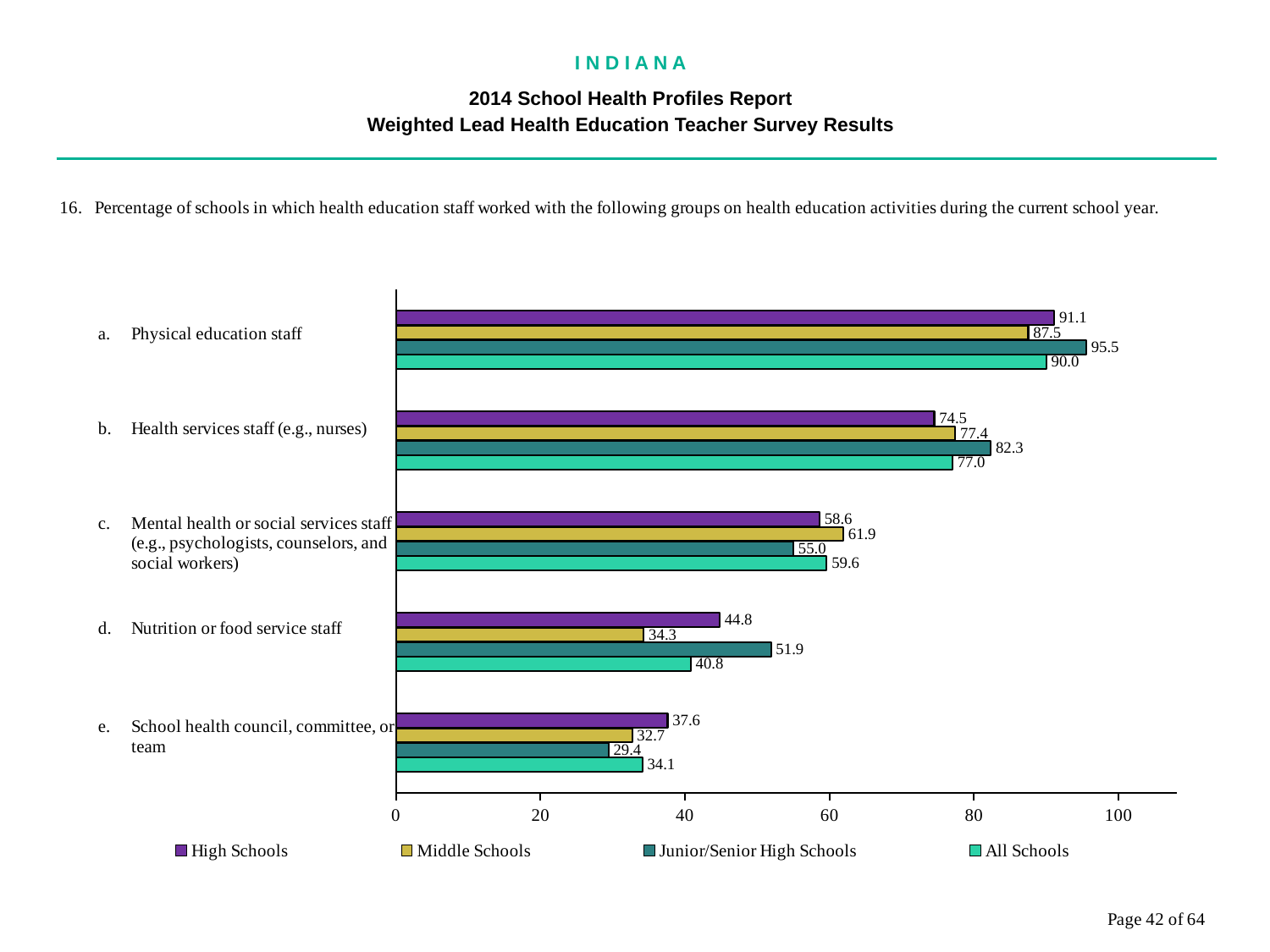
For Mental health or social services staff, which is larger: the Middle Schools value or the High Schools value? Middle Schools Which category has the highest All Schools value? Physical education staff What is the All Schools value for Nutrition or food service staff? 40.8 Is the High Schools value for Health services staff (e.g., nurses) greater or less than 80? less Which legend entry is shown in purple? High Schools Which category has the lowest High Schools value? School health council, committee, or team What is the value for Physical education staff in the Junior/Senior High Schools series? 95.5 What kind of chart is shown on the slide? bar chart What is the difference between the Junior/Senior High Schools and Middle Schools values for Nutrition or food service staff? 17.6 How many categories (groups) are shown on the chart? 5 How many series does the legend list? 4 What is the Middle Schools value for School health council, committee, or team? 32.7